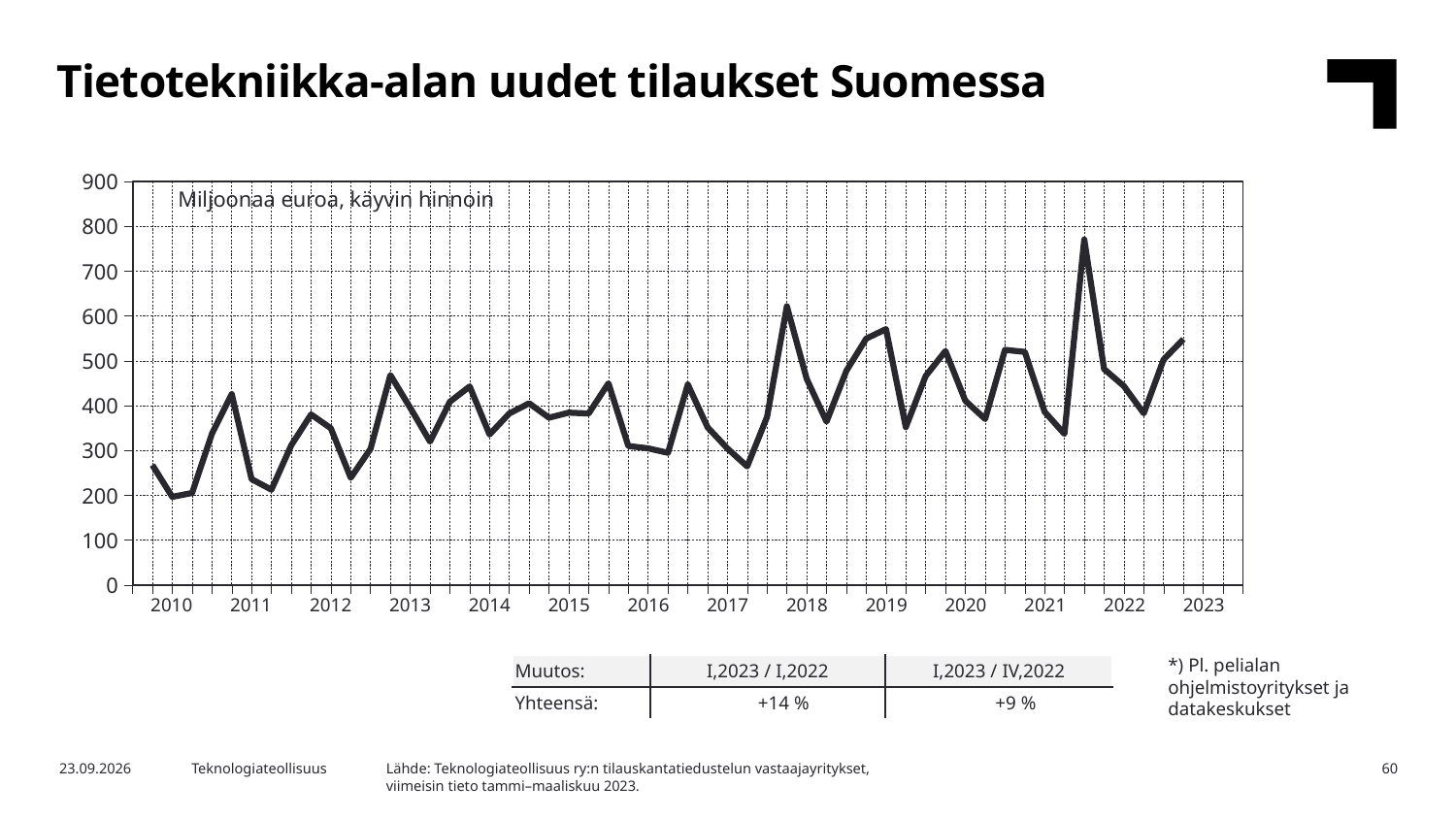
Is the first value of the line in 2010 greater or less than 300? less Comparing the first value in 2010 with the last value in 2023, which is larger? 2023 Is the lowest point of the line in 2010 greater or less than 300? less In which year does the line reach its highest peak? 2021 Is the peak of the line around the start of 2018 greater or less than 500? greater What is the highest value shown on the y axis? 900 What unit is stated inside the chart area? Miljoonaa euroa, käyvin hinnoin What kind of chart is shown on the slide? line chart How many year labels are shown on the x axis? 14 What is the title of the chart? Tietotekniikka-alan uudet tilaukset Suomessa